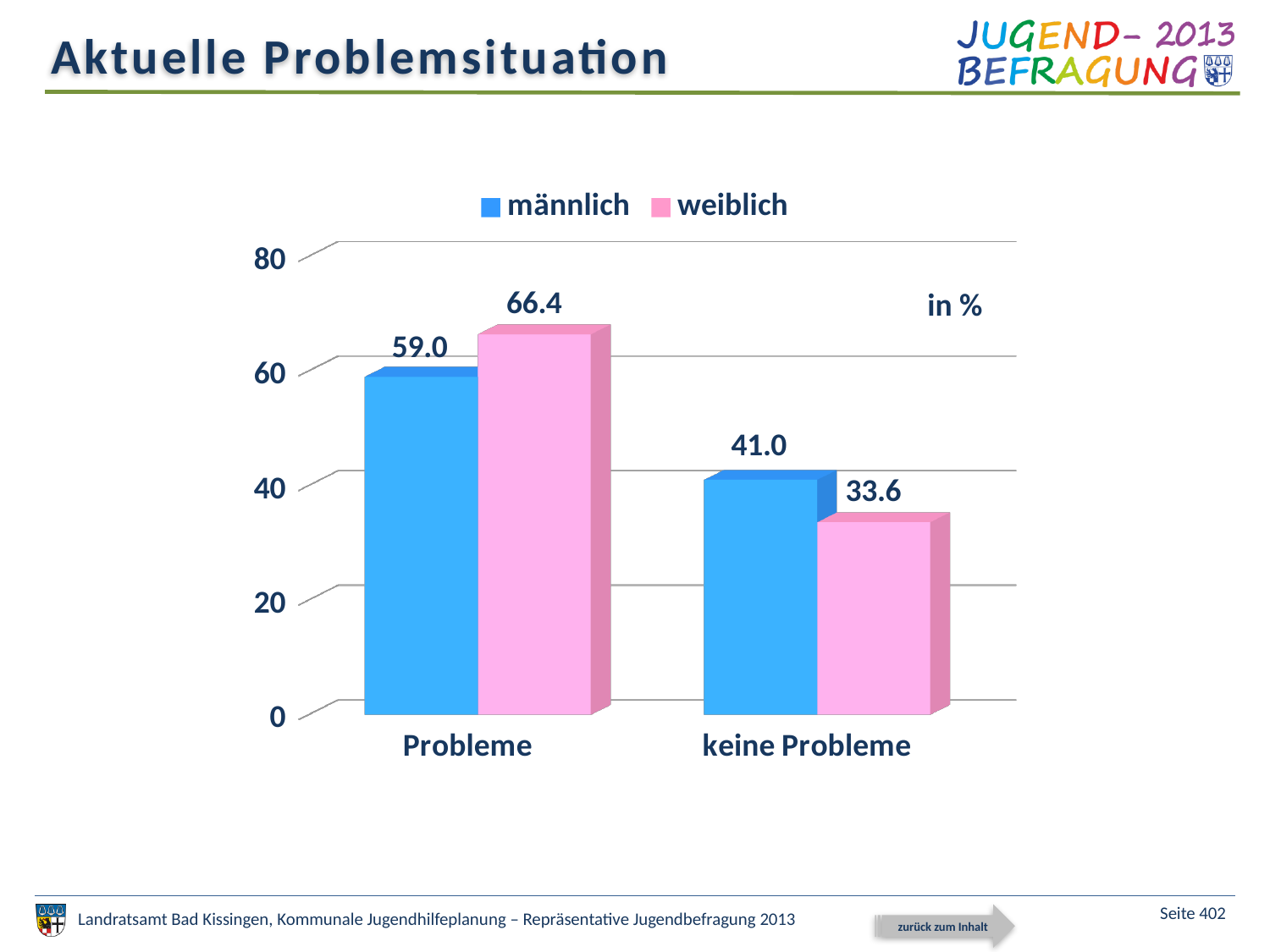
What kind of chart is shown on the slide? bar chart What is the value for männlich in the keine Probleme category? 41.0 In the keine Probleme category, which series has the larger value, männlich or weiblich? männlich How many series does the legend list? 2 What is the value for weiblich in the Probleme category? 66.4 How many categories are shown on the x axis? 2 What is the difference between the weiblich and männlich values in the Probleme category? 7.4 Which category has the lowest value for männlich? keine Probleme What is the value for männlich in the Probleme category? 59.0 What is the difference between the männlich and weiblich values in the keine Probleme category? 7.4 What is the value for weiblich in the keine Probleme category? 33.6 Which category has the highest value for weiblich? Probleme